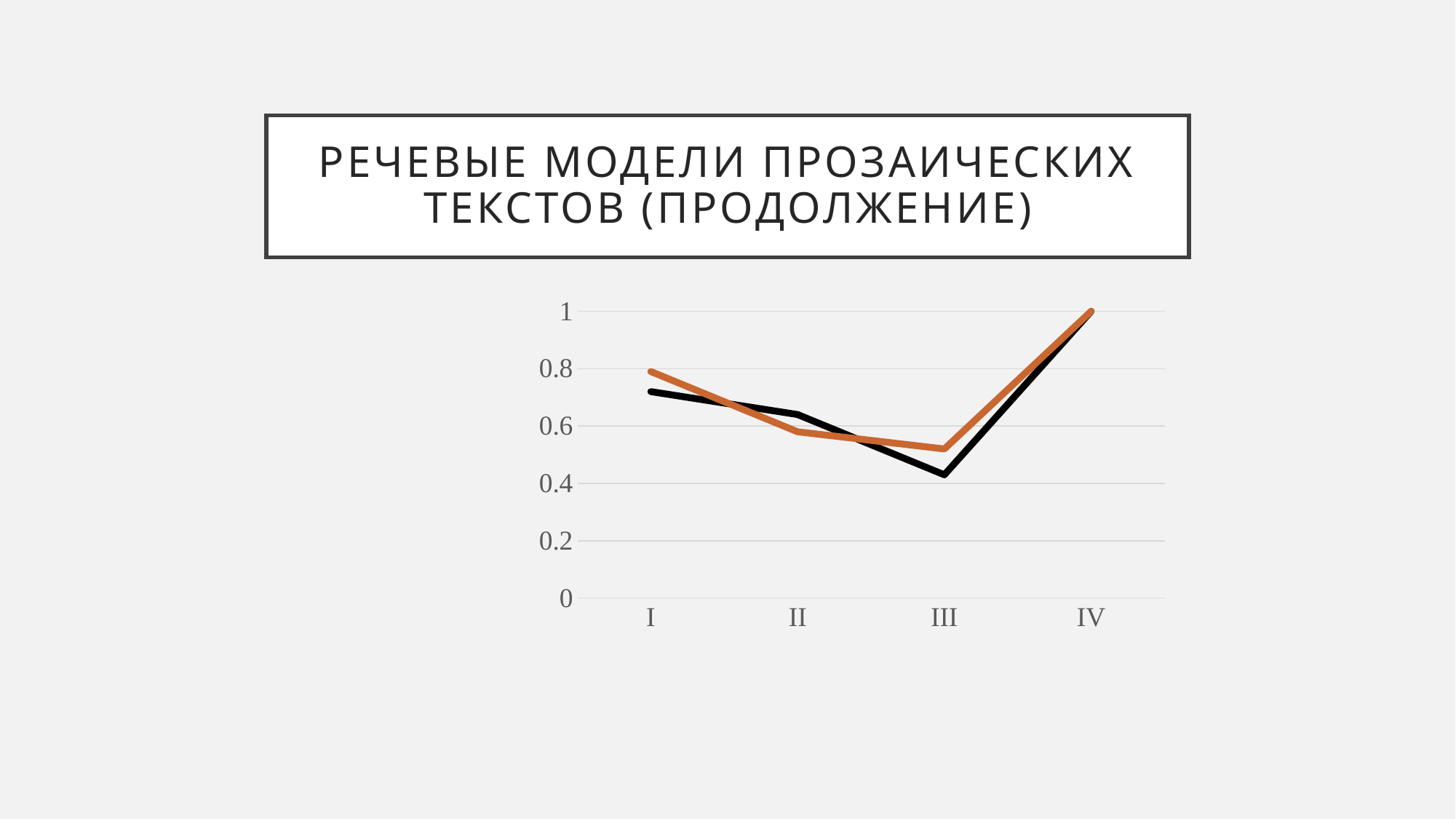
At category III, which line has the higher value, the black line or the orange line? orange line Is the value of the black line at category III greater or less than 0.6? less How many lines are plotted on the chart? 2 What is the title of the slide containing the chart? РЕЧЕВЫЕ МОДЕЛИ ПРОЗАИЧЕСКИХ ТЕКСТОВ (ПРОДОЛЖЕНИЕ) At which category does the black line reach its lowest value? III What is the value of the orange line at category IV? 1 What is the value of the black line at category IV? 1 Does the black line rise or fall from category II to category III? fall How many categories are shown on the x axis of the chart? 4 Is the value of the black line at category I greater or less than 0.8? less What kind of chart is shown on the slide? line chart Is the value of the orange line at category I greater or less than 0.6? greater